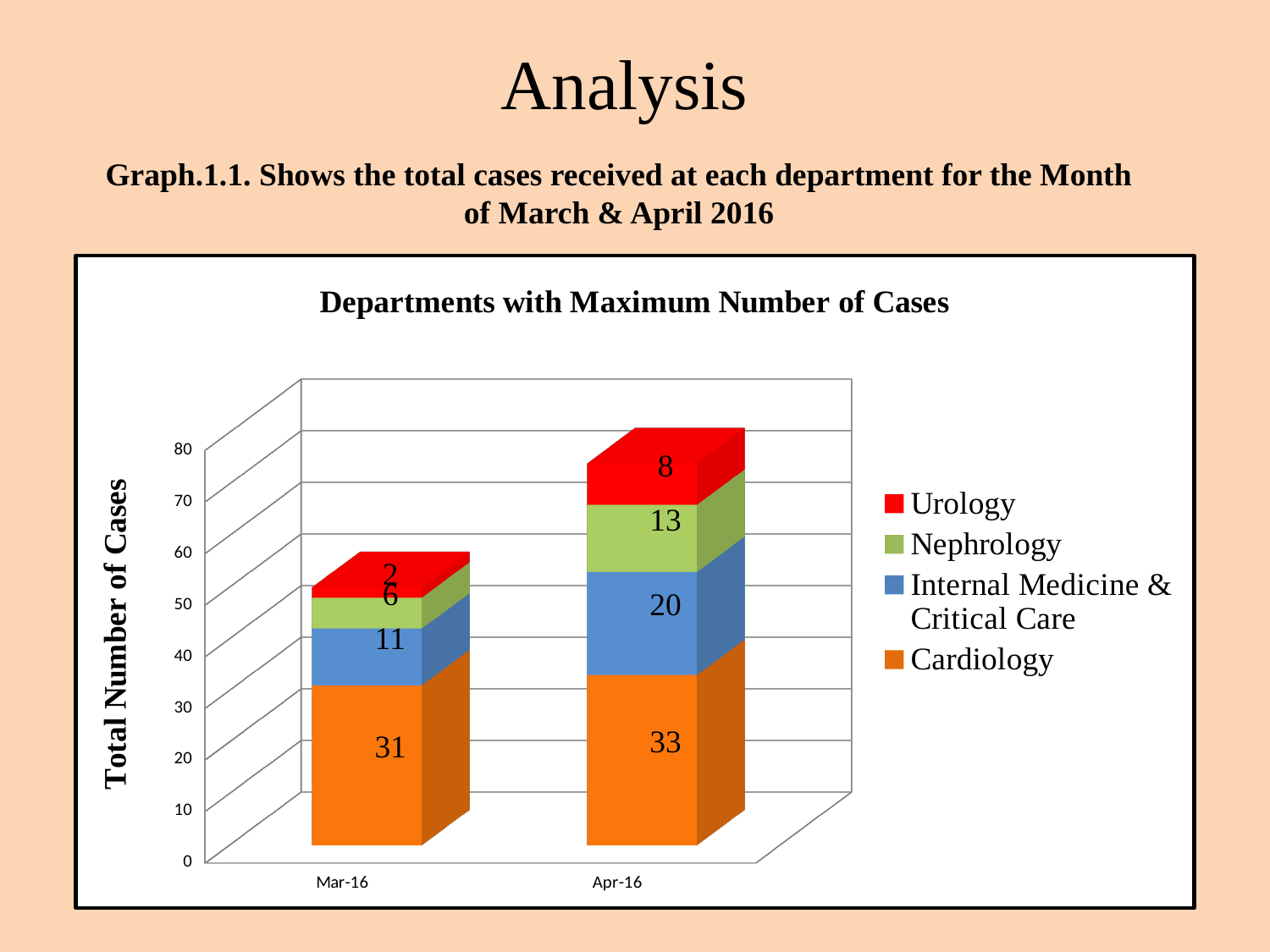
How many series does the legend list? 4 What is the title of the chart? Departments with Maximum Number of Cases Which department has the highest value in Mar-16? Cardiology What is the value for Internal Medicine & Critical Care in Mar-16? 11 What is the value for Cardiology in Apr-16? 33 What is the difference between the Internal Medicine & Critical Care values for Apr-16 and Mar-16? 9 What is the total of the stacked bar for Apr-16? 74 Which is larger, the Nephrology value in Mar-16 or in Apr-16? Apr-16 Which department has the lowest value in Apr-16? Urology What is the value for Nephrology in Apr-16? 13 What is the value for Urology in Apr-16? 8 What kind of chart is shown? Stacked bar chart